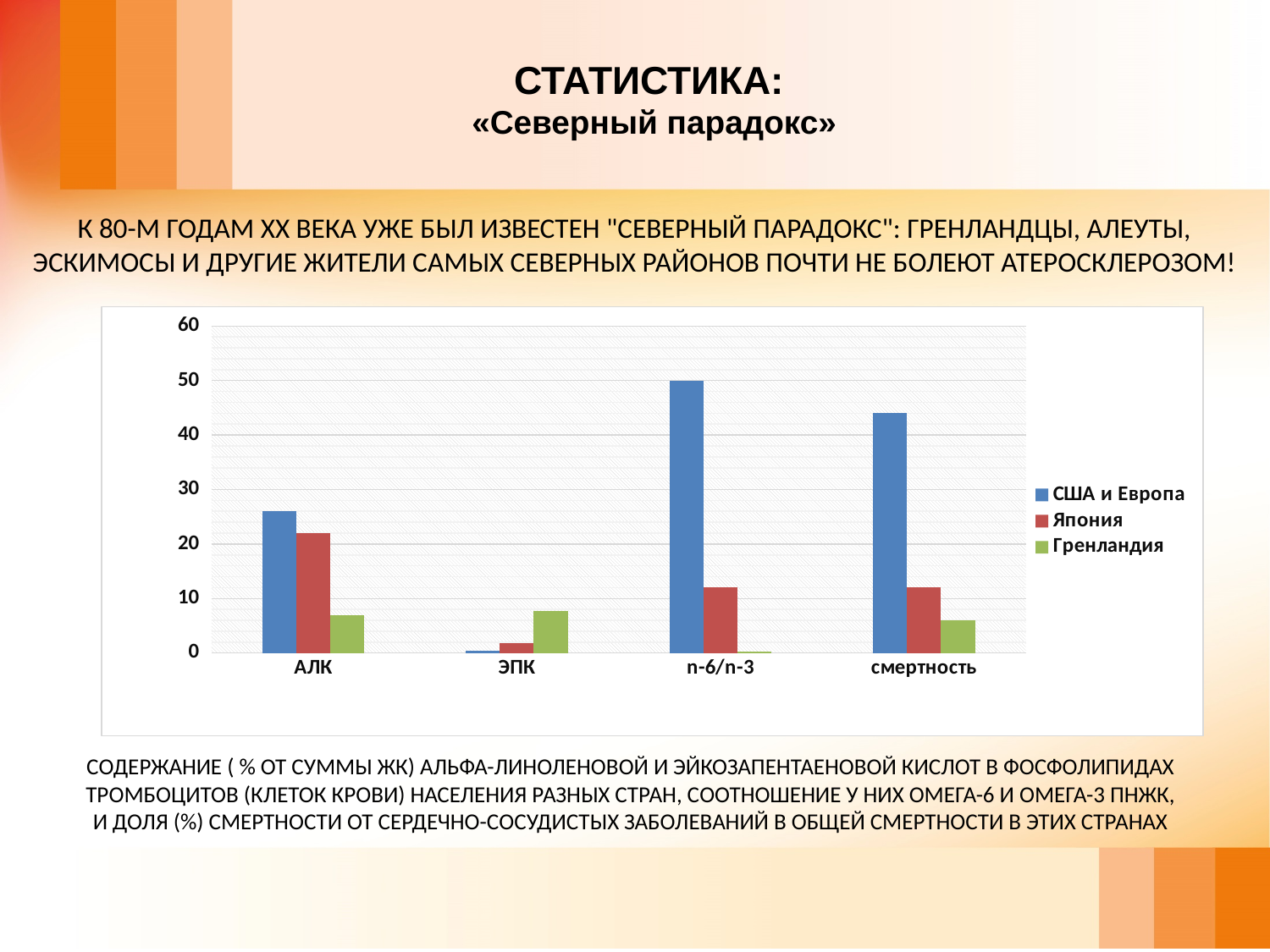
How many series does the legend list? 3 Which series has the lowest value for АЛК? Гренландия Which series has the highest value for n-6/n-3? США и Европа Is the value for Гренландия in the смертность category greater or less than 10? less Which series has the highest value for ЭПК? Гренландия Is the value for США и Европа in the смертность category greater or less than 40? greater Is the value for Япония in the АЛК category greater or less than 20? greater What kind of chart is shown on the slide? bar chart Which is larger for смертность: the value for Япония or the value for Гренландия? Япония Which series is shown in green in the legend? Гренландия How many categories are shown on the x axis? 4 Which series has the lowest value for n-6/n-3? Гренландия